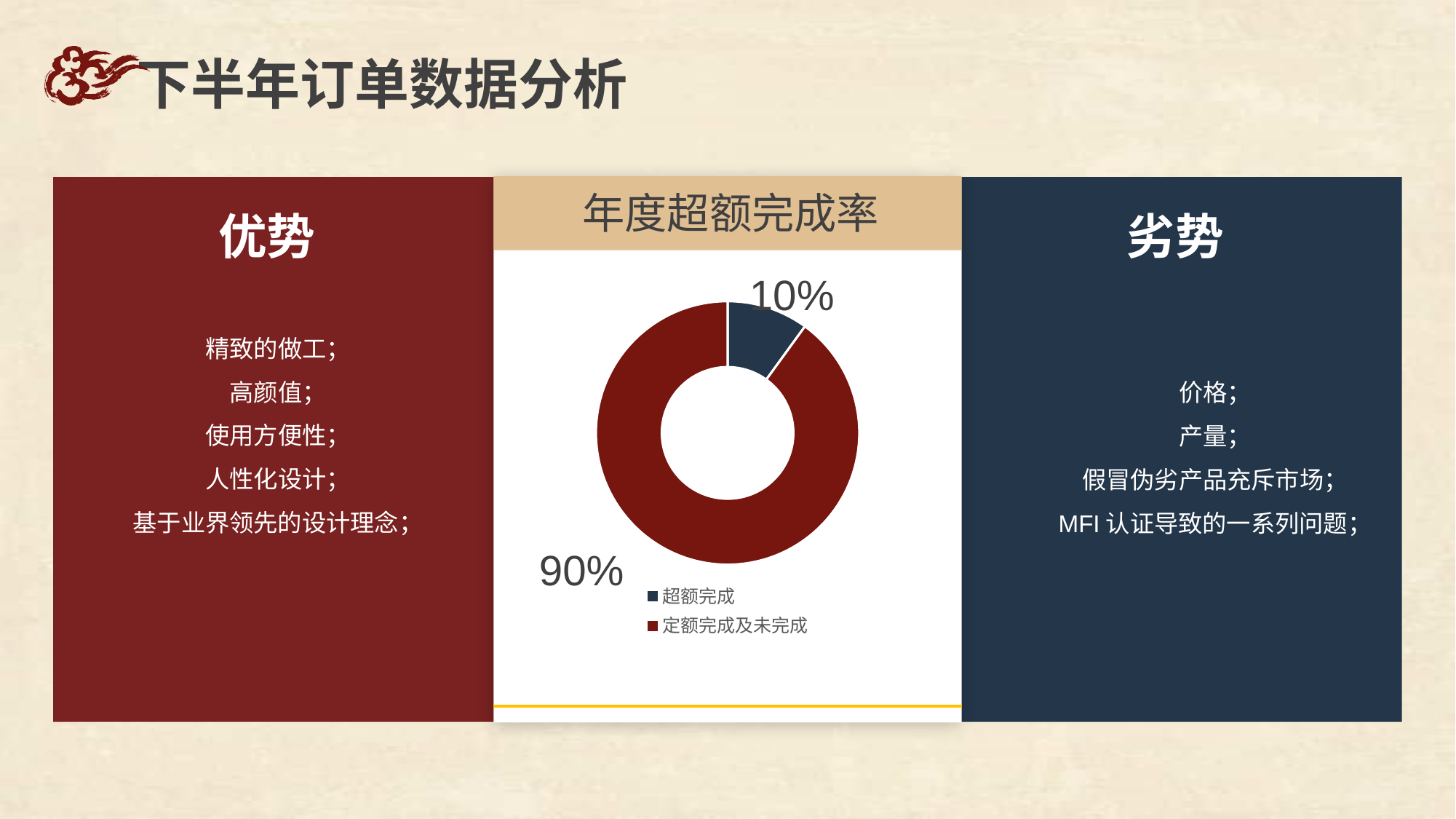
What is the value for 超额完成 in the chart? 10% Which is larger, the share of 超额完成 or the share of 定额完成及未完成? 定额完成及未完成 Which category has the smallest share in the chart? 超额完成 What colour represents 超额完成 in the chart? Dark blue How many categories does the chart show? 2 What is the difference between the shares of 定额完成及未完成 and 超额完成? 80% What is the value for 定额完成及未完成 in the chart? 90% What is the title of the chart? 年度超额完成率 How many entries does the chart legend list? 2 What kind of chart is shown under the title 年度超额完成率? Doughnut chart Which category has the largest share in the chart? 定额完成及未完成 What is the total of the two shares shown in the chart? 100%